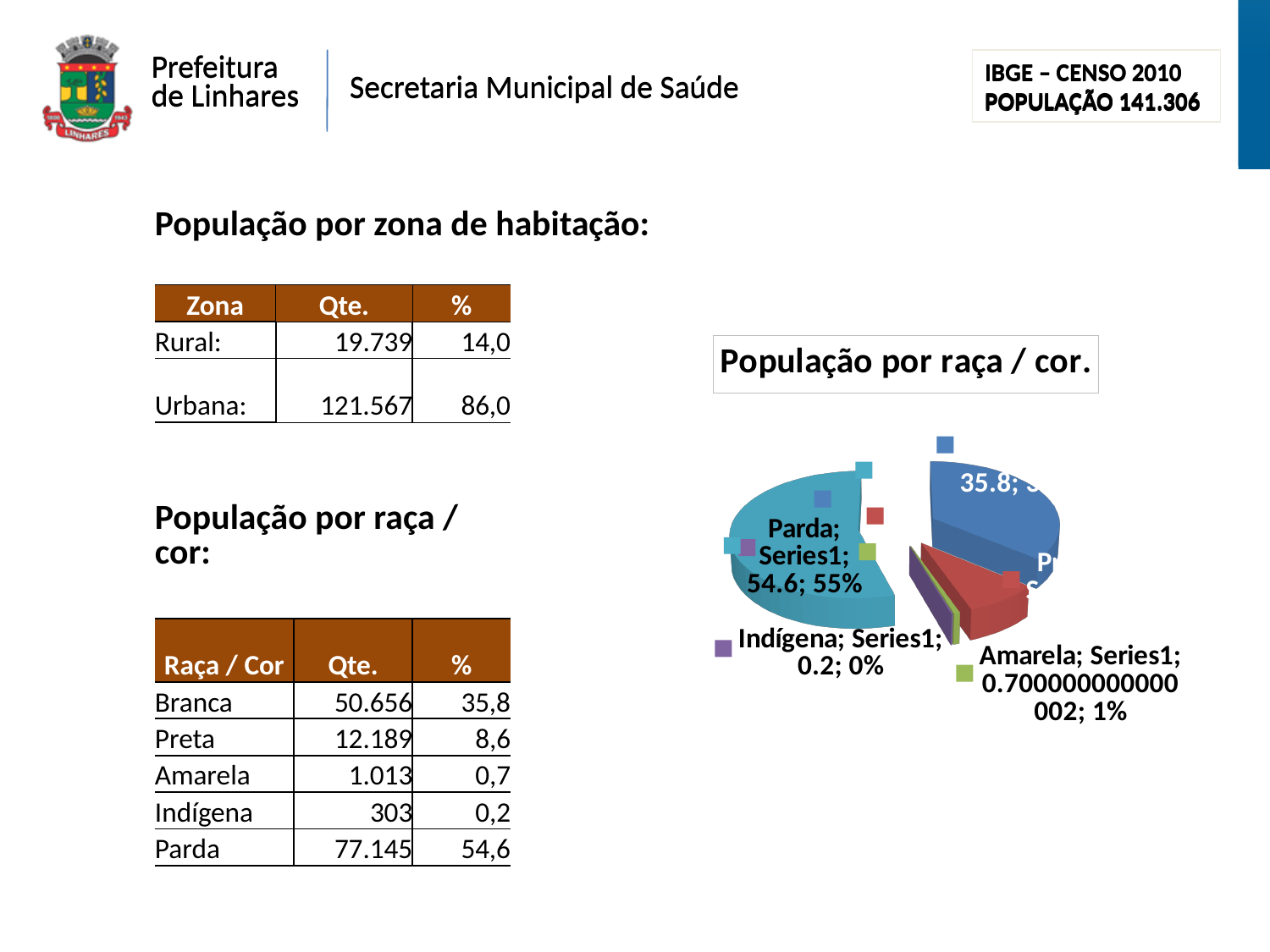
What kind of chart is shown on the slide? pie chart How many slices does the pie chart have? 5 In the pie chart, what value is shown for Indígena? 0.2 Which category has the smallest slice in the pie chart? Indígena In the pie chart, what percentage share is shown for Amarela? 1% In the pie chart, what is the difference between the value for Parda and the value for Indígena? 54.4 In the pie chart, what percentage share is shown for Indígena? 0% In the pie chart, what value is shown for Parda? 54.6 What is the title of the chart on the slide? População por raça / cor. In the pie chart, which is larger, the value for Parda or the value for Amarela? Parda Which category has the largest slice in the pie chart? Parda In the pie chart, what percentage share is shown for Parda? 55%